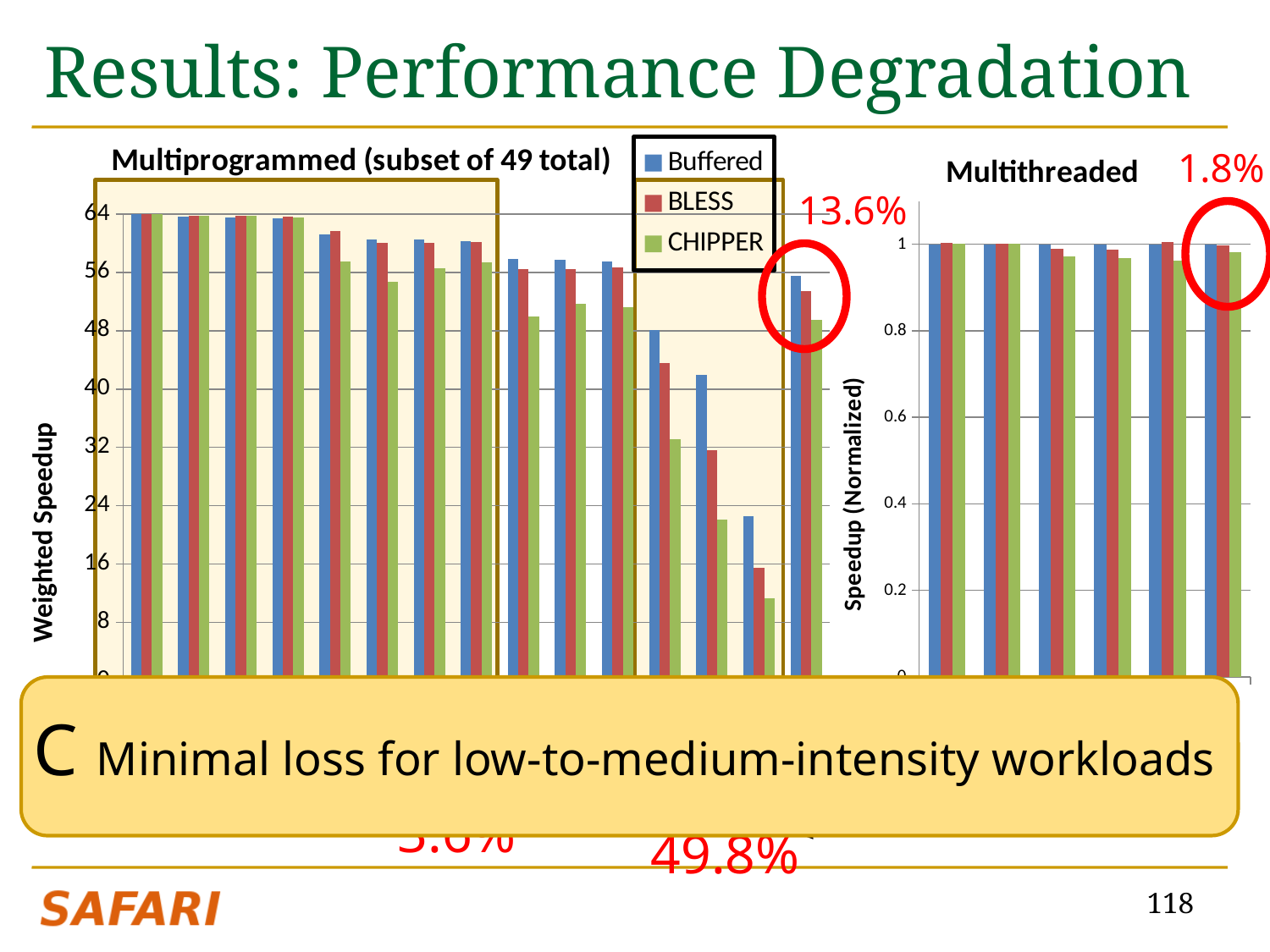
In the Multiprogrammed (subset of 49 total) chart, is the CHIPPER value for the second workload from the right greater or less than 16? less In the Multiprogrammed (subset of 49 total) chart, is the CHIPPER value for the third workload from the right greater or less than 24? less What is the y-axis title of the Multiprogrammed (subset of 49 total) chart? Weighted Speedup How many workload groups are plotted in the Multiprogrammed (subset of 49 total) chart? 15 How many series does the legend list for the charts? 3 In the Multiprogrammed (subset of 49 total) chart, for the third workload from the right, which is larger: the Buffered value or the CHIPPER value? Buffered Which series are listed in the legend? Buffered, BLESS, CHIPPER In the Multithreaded chart, is the Buffered value for the leftmost workload greater or less than 0.8? greater In the Multiprogrammed (subset of 49 total) chart, do the Buffered values generally rise or fall from left to right? fall What kind of chart is the Multiprogrammed (subset of 49 total) chart? bar chart How many workload groups are plotted in the Multithreaded chart? 6